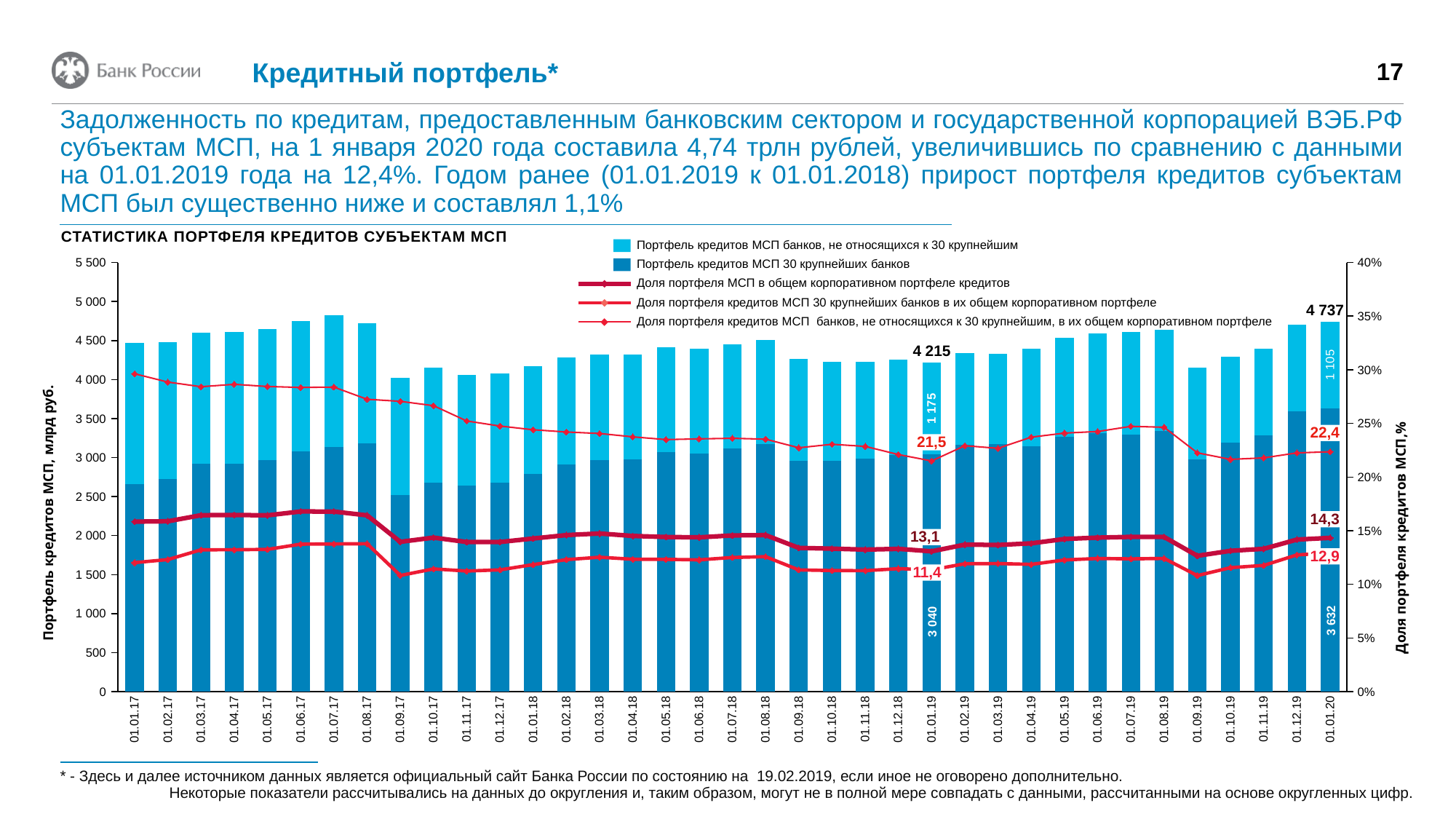
How many series does the legend list? 5 What is the difference between the total stacked bar values for 01.01.20 and 01.01.19? 522 What is the value of the 'Портфель кредитов МСП 30 крупнейших банков' segment for 01.01.20? 3 632 What is the value of 'Доля портфеля кредитов МСП 30 крупнейших банков в их общем корпоративном портфеле' for 01.01.19? 11,4 Which is larger: the 'Портфель кредитов МСП 30 крупнейших банков' segment for 01.01.20 or for 01.01.19? 01.01.20 What is the total value of the stacked bar for 01.01.19? 4 215 What is the value of the 'Портфель кредитов МСП банков, не относящихся к 30 крупнейшим' segment for 01.01.19? 1 175 What is the title of the chart? СТАТИСТИКА ПОРТФЕЛЯ КРЕДИТОВ СУБЪЕКТАМ МСП Is the total stacked bar value for 01.09.19 greater or less than 4 500? less What is the total value of the stacked bar for 01.01.20? 4 737 What kind of chart is shown on the slide? Stacked bar chart with line series What is the value of 'Доля портфеля МСП в общем корпоративном портфеле кредитов' for 01.01.20? 14,3